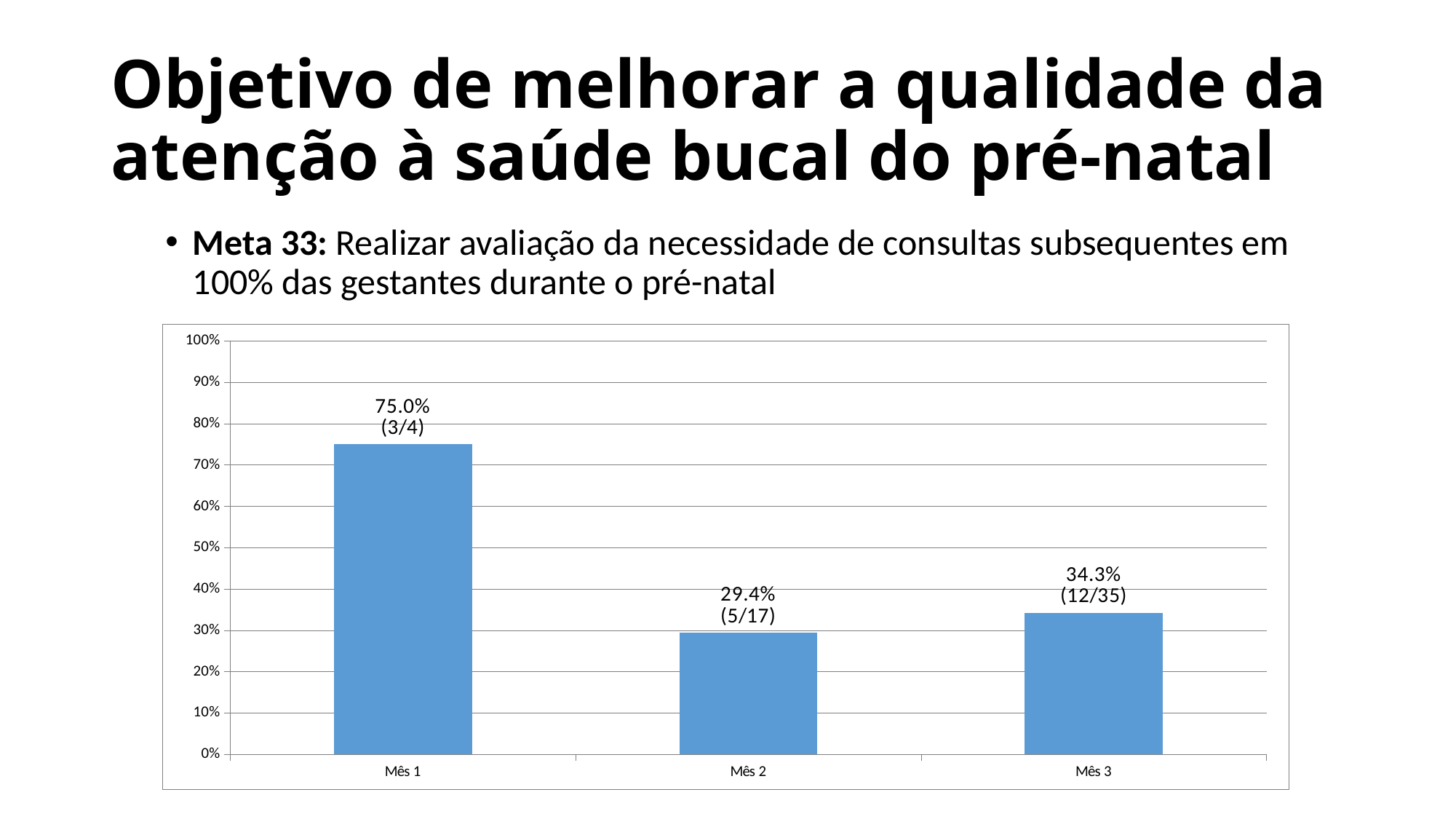
Is the value for Mês 2 greater or less than 30%? less What is the value for Mês 2? 29.4% Which month has the highest value? Mês 1 What kind of chart is shown on the slide? bar chart Which is larger, the value for Mês 2 or Mês 3? Mês 3 How many categories are shown on the x axis? 3 Which month has the lowest value? Mês 2 What is the highest value shown on the y axis? 100% What is the value for Mês 3? 34.3% What fraction is shown in the data label for Mês 3? 12/35 What is the value for Mês 1? 75.0% What is the difference between the values for Mês 1 and Mês 3? 40.7%